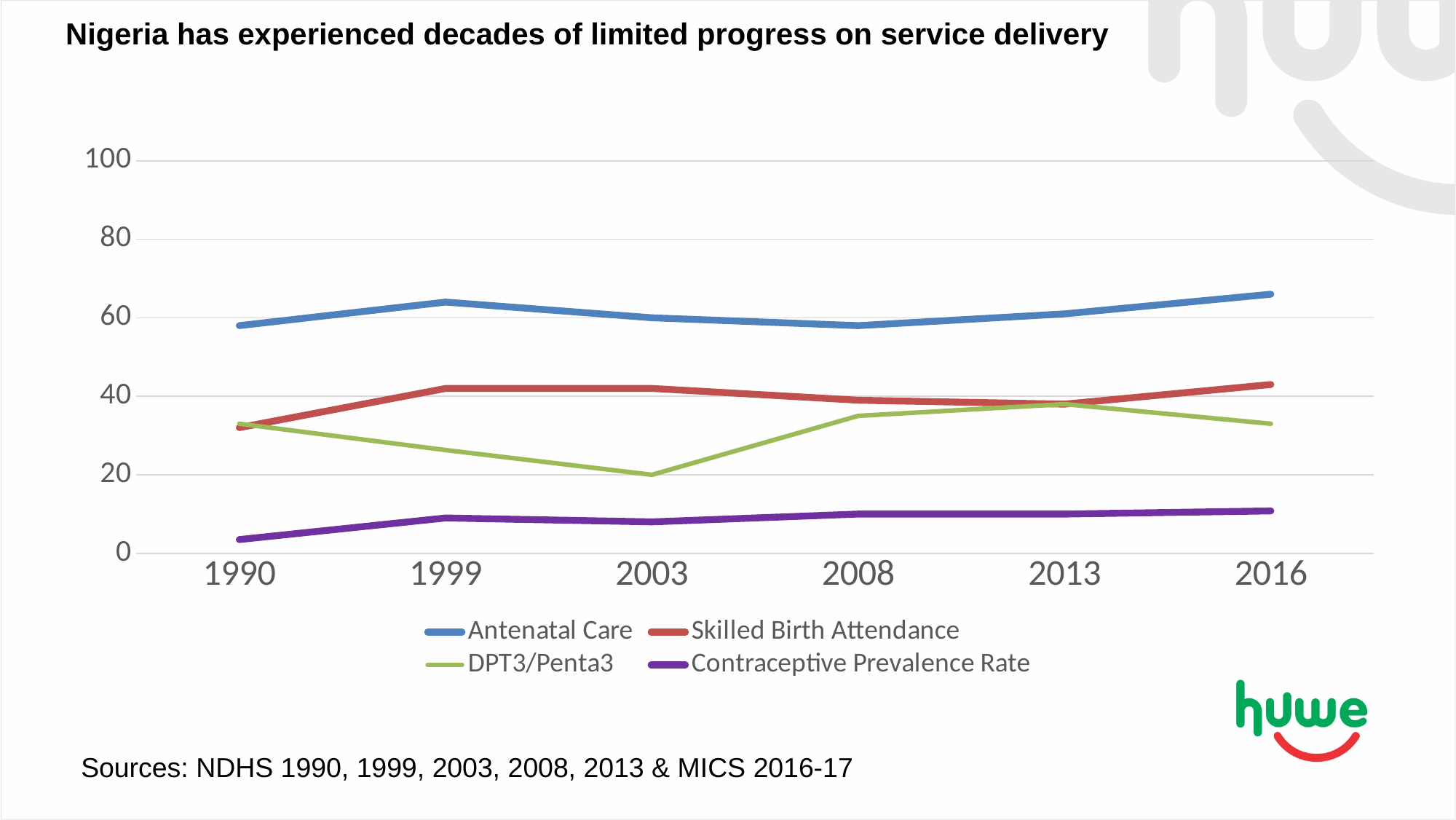
Is the value for DPT3/Penta3 in 2003 greater or less than 40? less In which year is DPT3/Penta3 at its lowest? 2003 How many years are shown along the x axis? 6 Is the value for Contraceptive Prevalence Rate in 2016 greater or less than 20? less Is the value for Antenatal Care in 1999 greater or less than 60? greater Which series has the highest value in 2016? Antenatal Care Does the DPT3/Penta3 line rise or fall from 1990 to 2003? fall Which series has the lowest value in 1990? Contraceptive Prevalence Rate In 2003, which is larger: Skilled Birth Attendance or DPT3/Penta3? Skilled Birth Attendance What kind of chart is shown on the slide? line chart How many series does the legend list? 4 What is the title of the chart? Nigeria has experienced decades of limited progress on service delivery